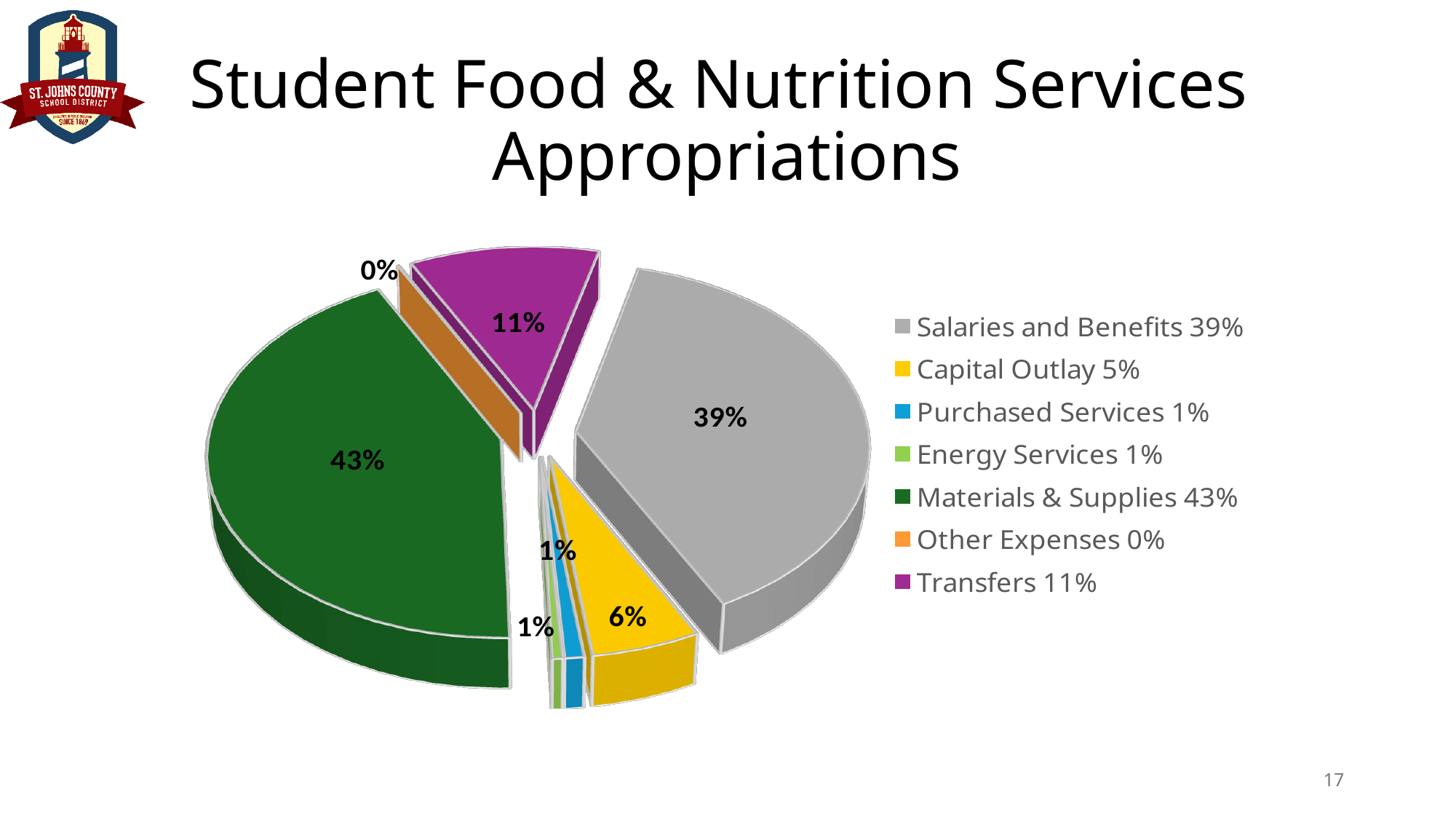
What share of appropriations goes to Purchased Services? 1% What share of appropriations goes to Other Expenses? 0% What share of appropriations goes to Transfers? 11% What share of appropriations goes to Materials & Supplies? 43% Which is larger, the share for Salaries and Benefits or the share for Transfers? Salaries and Benefits How many percentage points larger is the Materials & Supplies share than the Salaries and Benefits share? 4 percentage points How many categories does the pie chart show? 7 What colour is the Transfers slice of the pie? Purple Which category has the largest share of the pie? Materials & Supplies What kind of chart is shown on the slide? Pie chart What share of appropriations goes to Salaries and Benefits? 39% Which category has the smallest share of the pie? Other Expenses